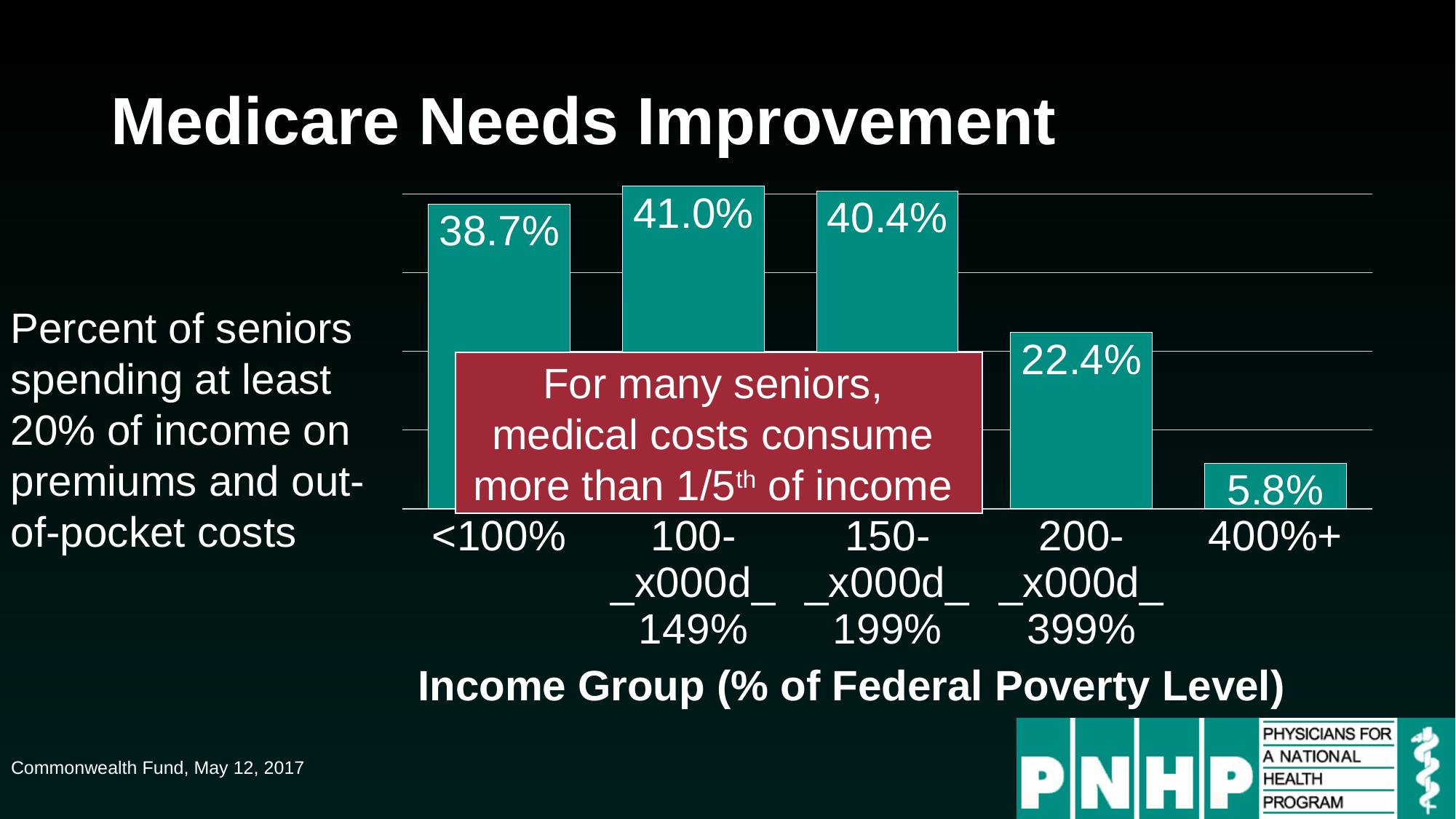
Which income group has the lowest value? 400%+ What is the title of the x axis of the chart? Income Group (% of Federal Poverty Level) What is the value for the 100-149% income group? 41.0% Which is larger, the value for the 150-199% group or the 200-399% group? 150-199% What is the value for the 200-399% income group? 22.4% What is the value for the 400%+ income group? 5.8% What is the difference between the values for the 100-149% and <100% income groups? 2.3% What kind of chart is shown on the slide? Bar chart What is the difference between the values for the 200-399% and 400%+ income groups? 16.6% Which income group has the highest value? 100-149% How many income groups are shown in the chart? 5 What is the value for the <100% income group? 38.7%